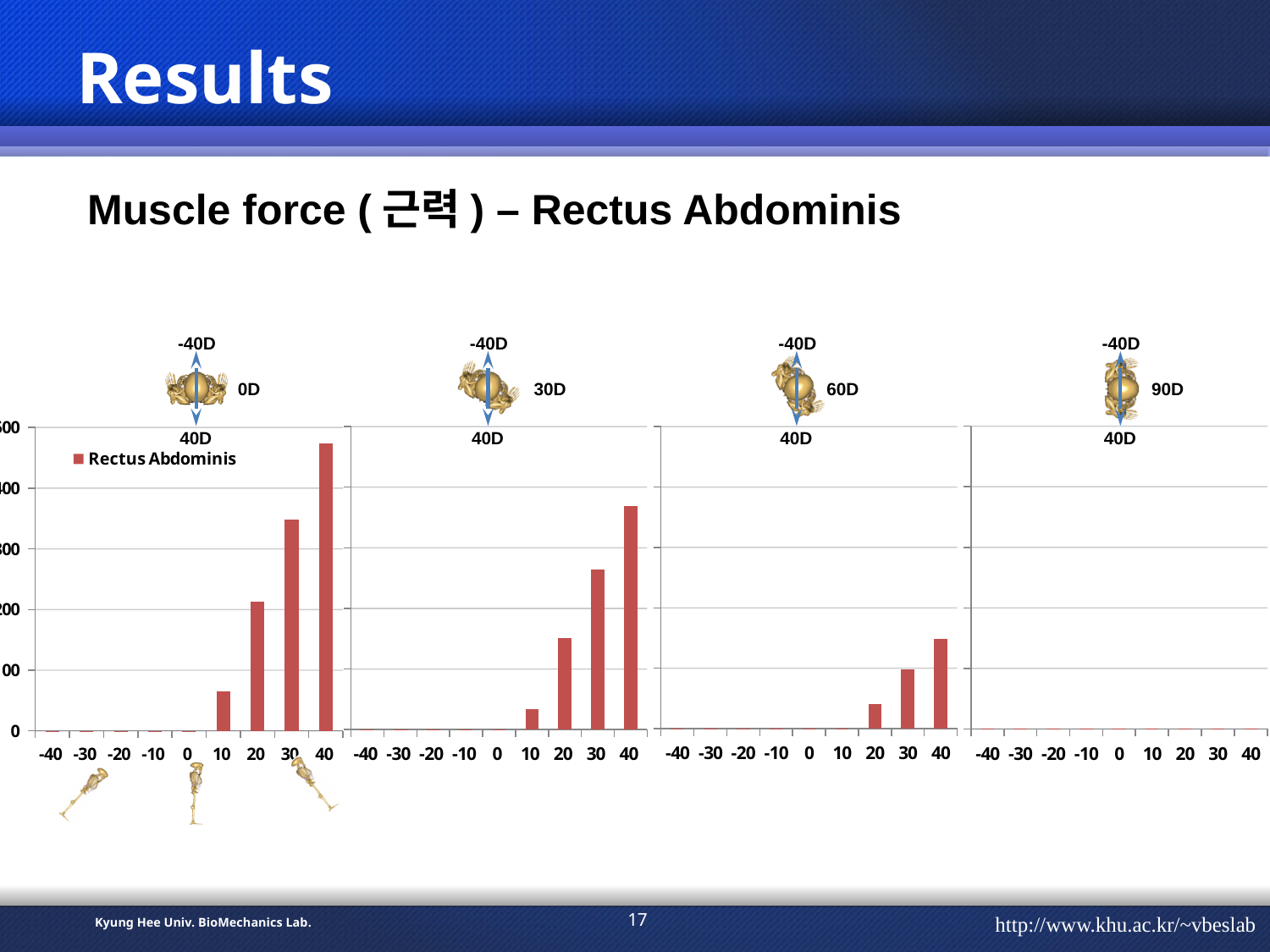
What kind of chart is used in the 0D panel? bar chart In the 0D chart, is the value at 30 greater or less than 300? greater In the 60D chart, is the value at 30 greater or less than 200? less In the 60D chart, which x-axis category has the highest value? 40 In the 30D chart, is the value at 20 greater or less than 100? greater What is the name of the series shown in the legend of the 0D chart? Rectus Abdominis Which is larger: the value at 40 in the 0D chart or the value at 40 in the 30D chart? 0D chart In the 0D chart, which x-axis category has the highest value? 40 How many x-axis categories are shown in the 0D chart? 9 How many series does the legend in the 0D chart list? 1